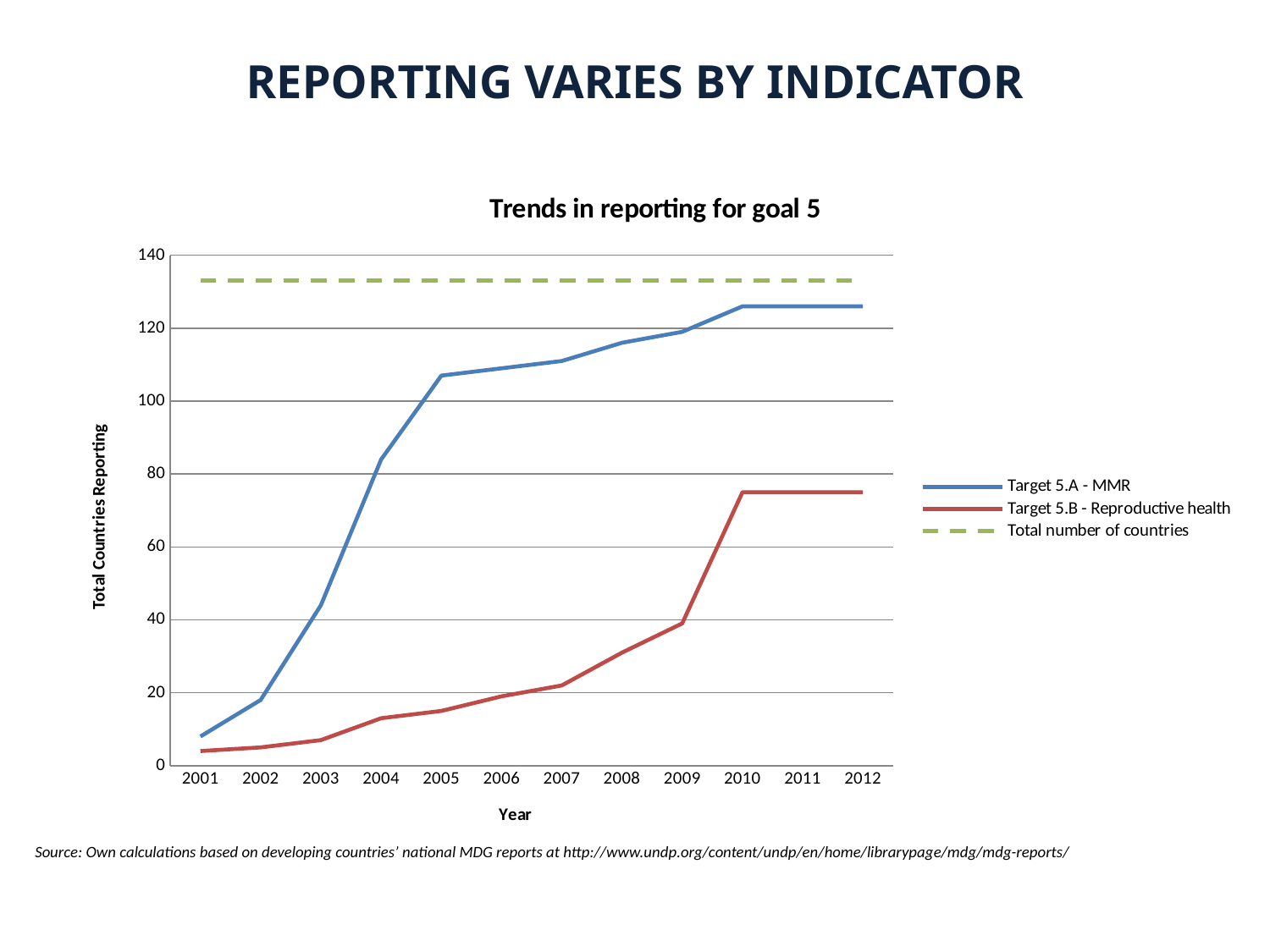
In 2012, which series is larger: Target 5.A - MMR or Target 5.B - Reproductive health? Target 5.A - MMR How many years are shown on the x axis? 12 What is the label of the y axis? Total Countries Reporting Is the value for Target 5.A - MMR in 2001 greater or less than 20? less Is the value for Target 5.A - MMR in 2005 greater or less than 100? greater Does the Target 5.A - MMR series rise or fall from 2001 to 2012? rise What is the title of the chart? Trends in reporting for goal 5 Is the Total number of countries line greater or less than 120? greater In which year is the Target 5.B - Reproductive health series lowest? 2001 What kind of chart is shown on the slide? line chart How many series does the legend list? 3